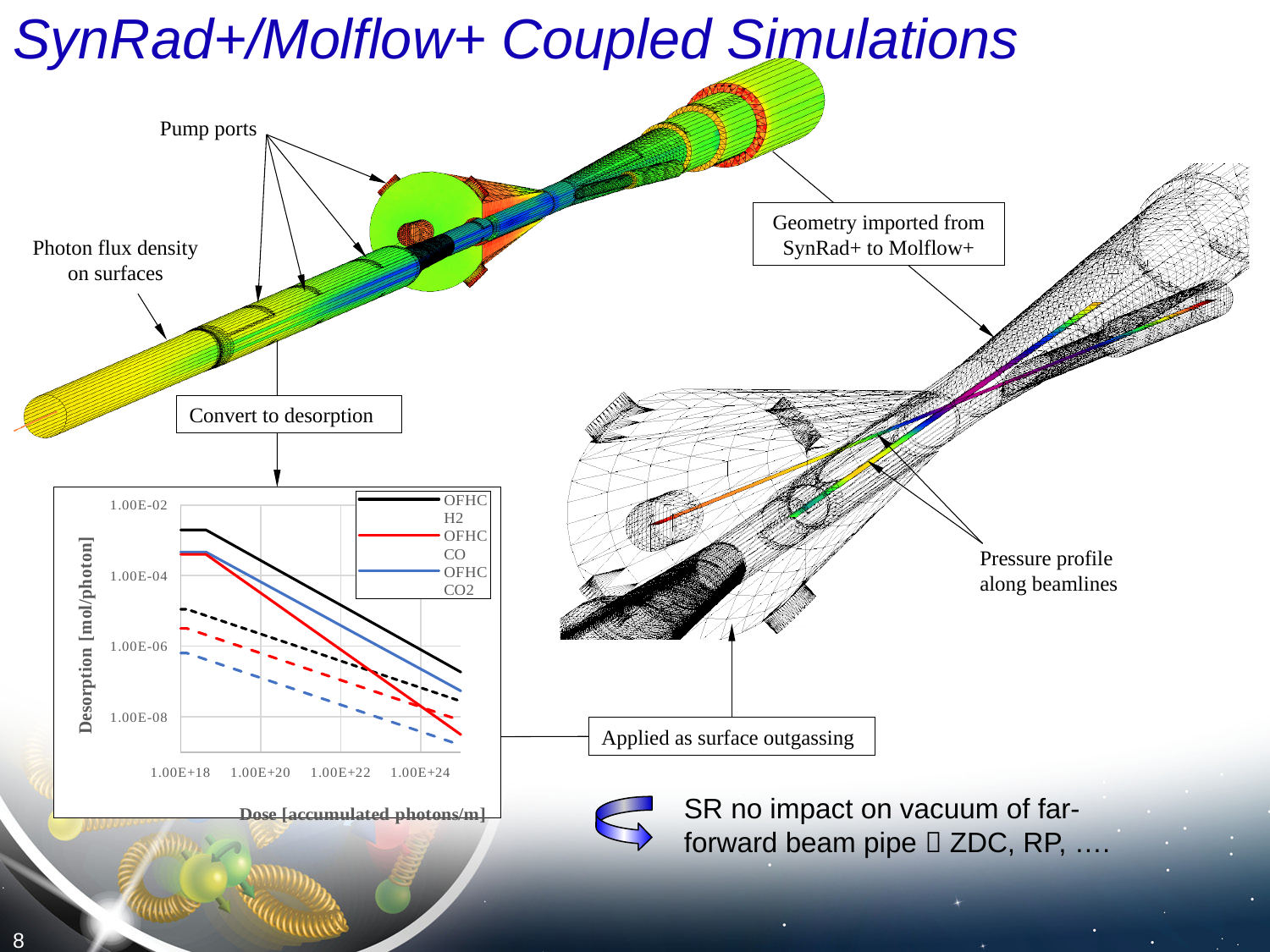
How many series does the chart legend list? 3 What is the title of the chart's y axis? Desorption [mol/photon] What is the title of the chart's x axis? Dose [accumulated photons/m] Is the solid-line desorption for OFHC H2 at a dose of 1.00E+18 greater or less than 1.00E-04? greater What kind of chart is shown on the slide? line chart Is the solid-line desorption for OFHC CO2 at a dose of 1.00E+18 greater or less than 1.00E-06? greater Do the desorption values rise or fall as the dose increases along the x axis? fall Which series has the highest desorption across the plotted dose range? OFHC H2 Among the solid lines, which series has the lowest desorption at a dose of 1.00E+24? OFHC CO How many tick labels are shown on the chart's x axis? 4 Is the solid-line desorption for OFHC CO at a dose of 1.00E+24 greater or less than 1.00E-06? less At a dose of 1.00E+24, is the solid-line desorption for OFHC H2 higher or lower than for OFHC CO? higher